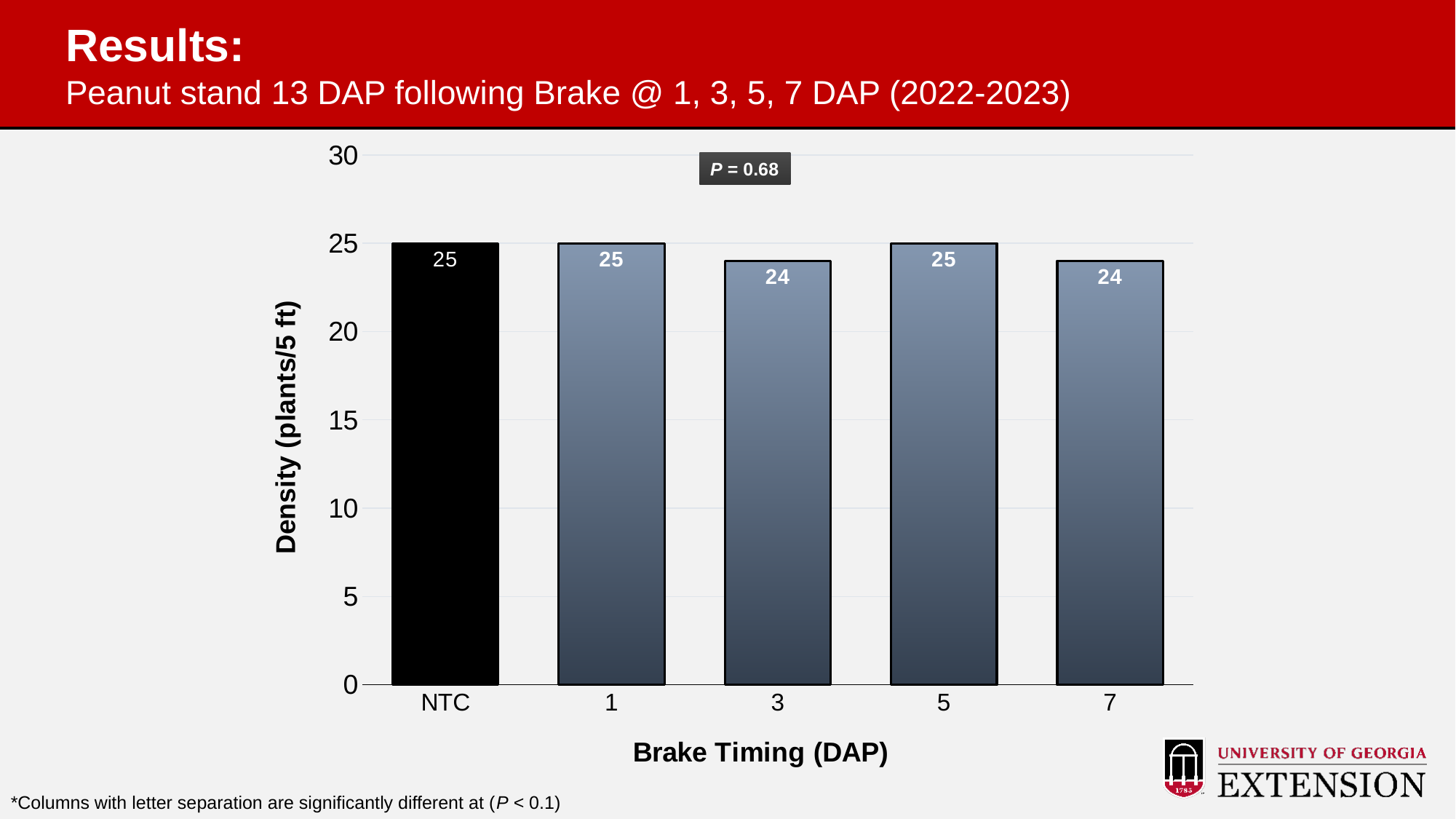
What is the density value for brake timing 3 DAP? 24 What is the difference in density between NTC and brake timing 3 DAP? 1 What is the density value for brake timing 7 DAP? 24 Is the density value for brake timing 5 DAP greater or less than 20? greater What is the density value for NTC? 25 What P value is shown on the chart? P = 0.68 How many categories are shown on the x axis? 5 What is the label of the x axis? Brake Timing (DAP) What is the density value for brake timing 5 DAP? 25 What kind of chart is shown on the slide? bar chart What is the label of the y axis? Density (plants/5 ft) Which has a higher density value, brake timing 1 DAP or brake timing 7 DAP? 1